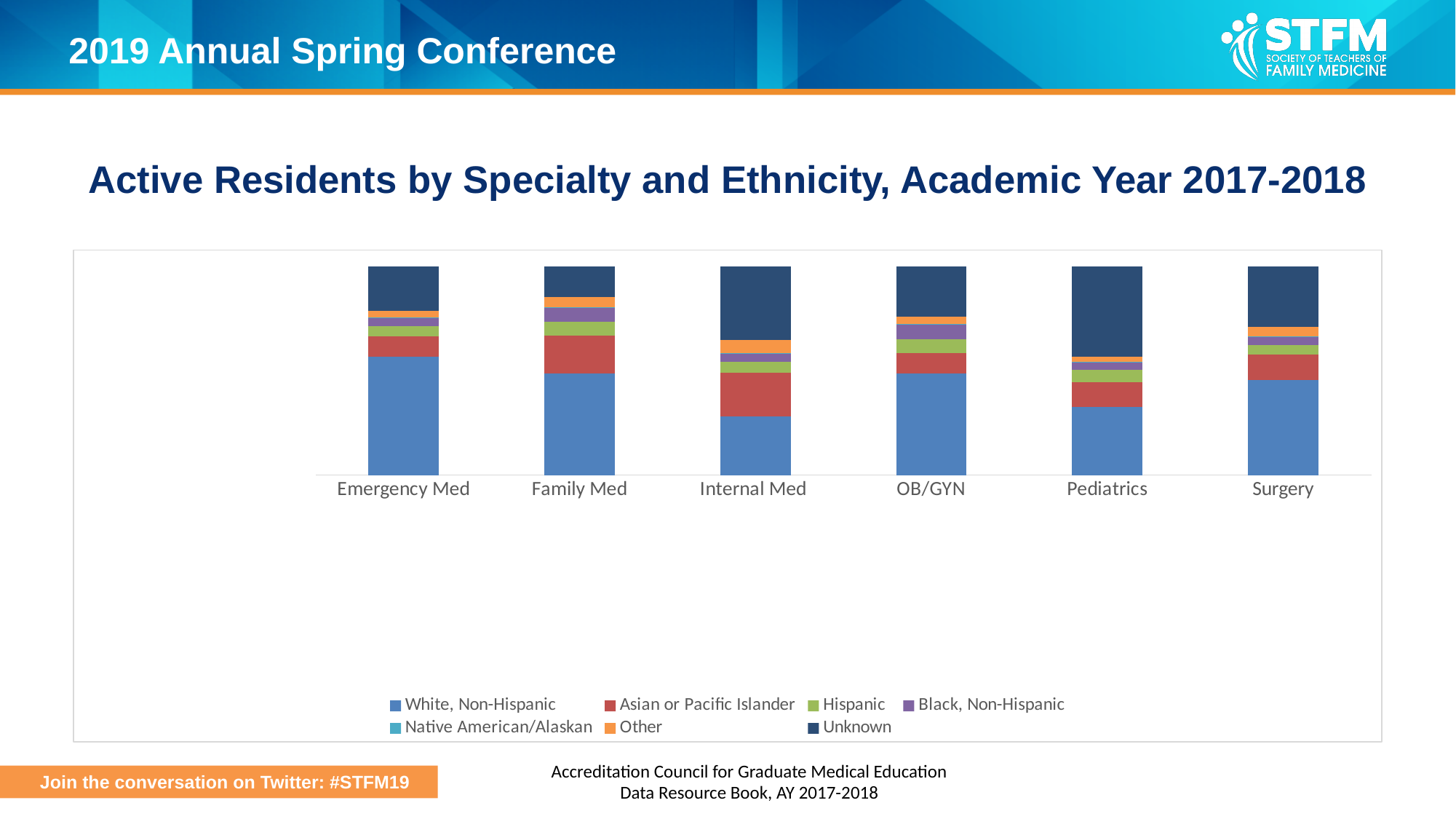
Which specialty has the largest Unknown share of active residents? Pediatrics How many specialties are shown along the x axis of the chart? 6 What is the title of the chart on the slide? Active Residents by Specialty and Ethnicity, Academic Year 2017-2018 Is the Asian or Pacific Islander share larger for Internal Med or for Emergency Med? Internal Med Which specialty has the smallest White, Non-Hispanic share of active residents? Internal Med What kind of chart is shown on the slide? Stacked bar chart Is the Unknown share larger for Pediatrics or for Emergency Med? Pediatrics How many ethnicity series does the chart legend list? 7 Which series is listed last in the chart legend? Unknown Which specialty has the largest White, Non-Hispanic share of active residents? Emergency Med Which specialty is shown first on the x axis of the chart? Emergency Med Is the White, Non-Hispanic share larger for Emergency Med or for Internal Med? Emergency Med